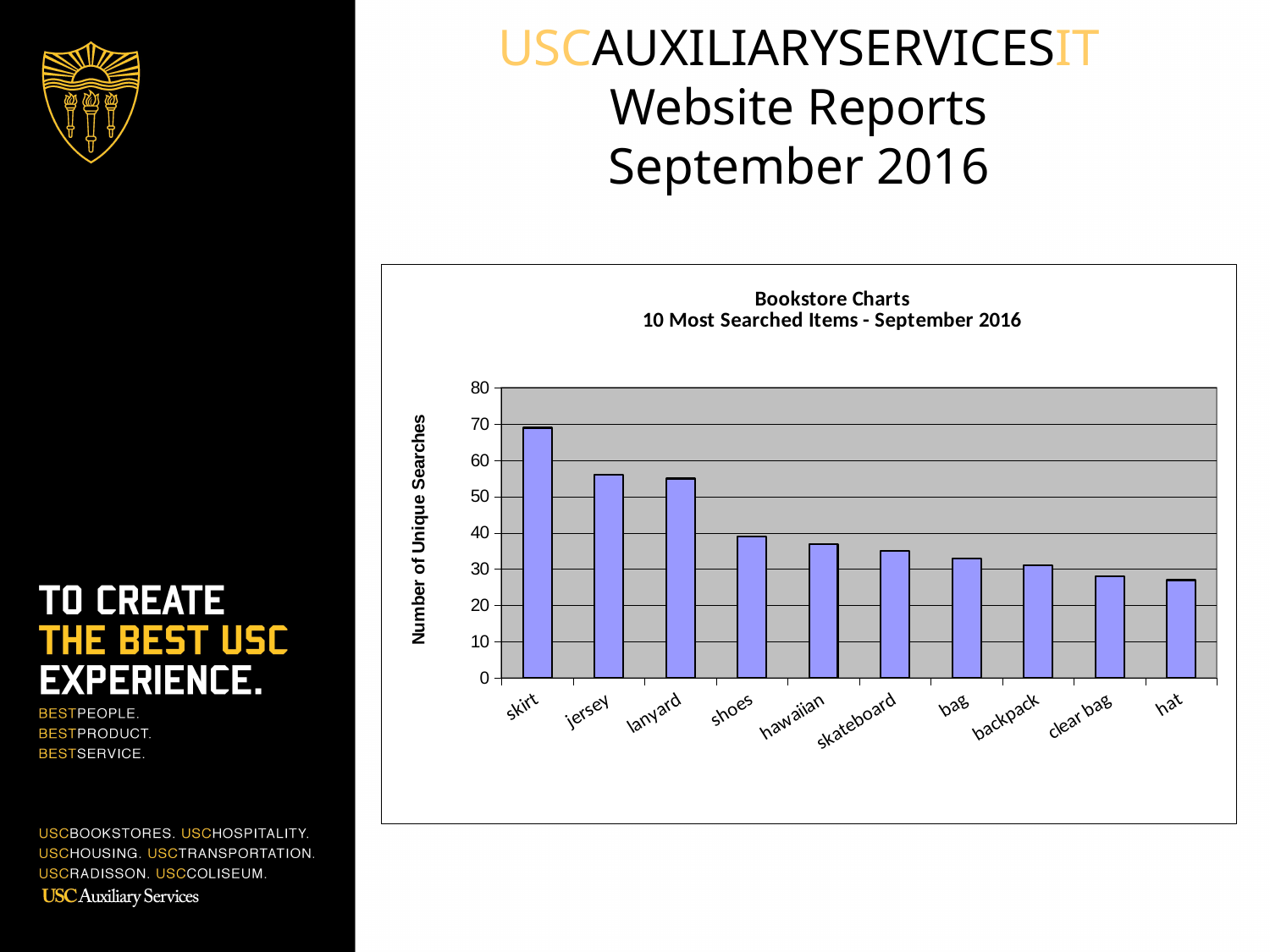
What kind of chart is shown on the slide? bar chart Which item has the highest number of unique searches? skirt Which has more unique searches, bag or skirt? skirt Which has more unique searches, lanyard or hawaiian? lanyard Is the value for skateboard greater or less than 40? less Is the value for jersey greater or less than 50? greater What is the label on the y axis of the chart? Number of Unique Searches Is the value for hat greater or less than 20? greater Do the values rise or fall moving from left to right along the x axis? fall How many items are shown on the x axis of the chart? 10